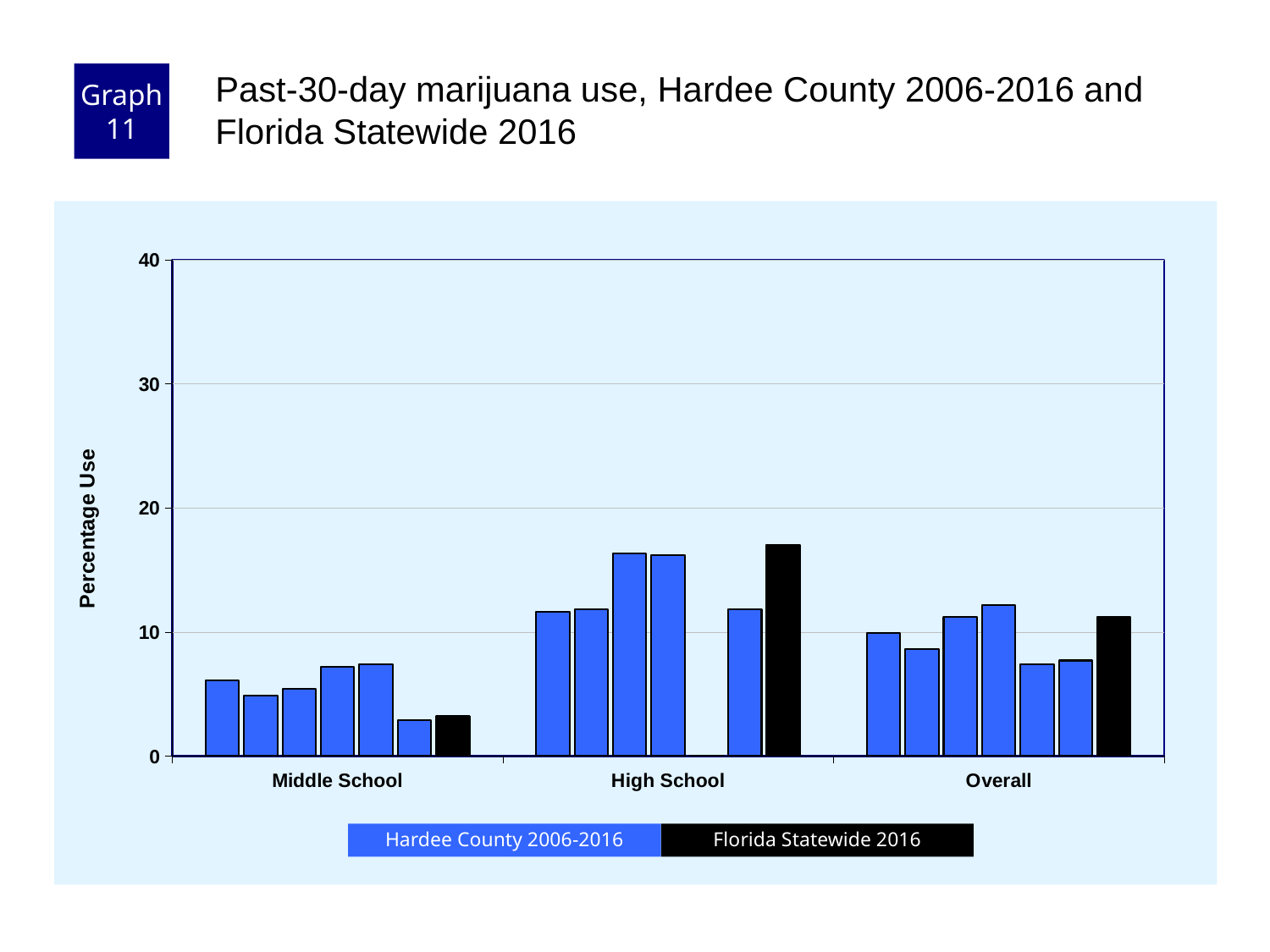
Is the Florida Statewide 2016 value for Overall greater or less than 10? greater How many series does the legend list? 2 Which category has the highest Florida Statewide 2016 bar? High School How many categories are shown on the x axis? 3 Is the Florida Statewide 2016 value for Middle School greater or less than 10? less Which category has the lowest Florida Statewide 2016 bar? Middle School What is the label on the y axis? Percentage Use Are all the Middle School bars above or below 10? below Which is larger, the Florida Statewide 2016 value for High School or for Overall? High School What kind of chart is shown on the slide? bar chart Which colour represents Florida Statewide 2016 in the legend? black